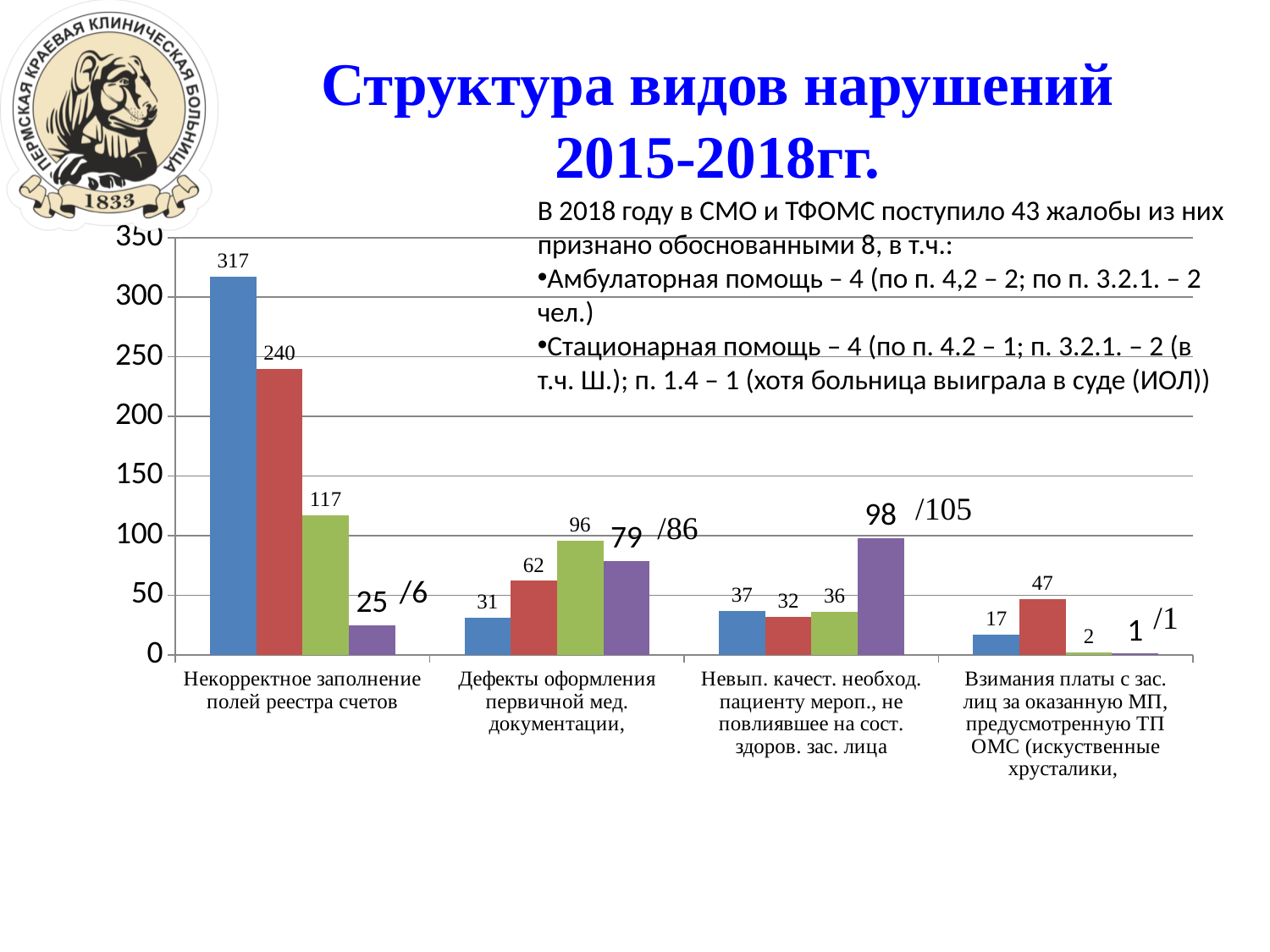
What type of chart is shown on the slide? bar chart How many categories are shown on the x axis of the chart? 4 What is the value of the red bar for the category 'Некорректное заполнение полей реестра счетов'? 240 For 'Дефекты оформления первичной мед. документации', which is larger: the green bar or the purple bar? the green bar What is the value of the green bar for the category 'Дефекты оформления первичной мед. документации'? 96 What is the value of the purple bar for the category 'Невып. качест. необход. пациенту мероп., не повлиявшее на сост. здоров. зас. лица'? 98 Which category has the lowest green bar? Взимания платы с зас. лиц за оказанную МП, предусмотренную ТП ОМС What is the difference between the blue bar (317) and the red bar (240) for 'Некорректное заполнение полей реестра счетов'? 77 What is the value of the blue bar for the category 'Некорректное заполнение полей реестра счетов'? 317 What is the value of the red bar for the category 'Взимания платы с зас. лиц за оказанную МП, предусмотренную ТП ОМС'? 47 Is the value of the green bar for 'Некорректное заполнение полей реестра счетов' greater or less than 100? greater Which category has the highest blue bar? Некорректное заполнение полей реестра счетов